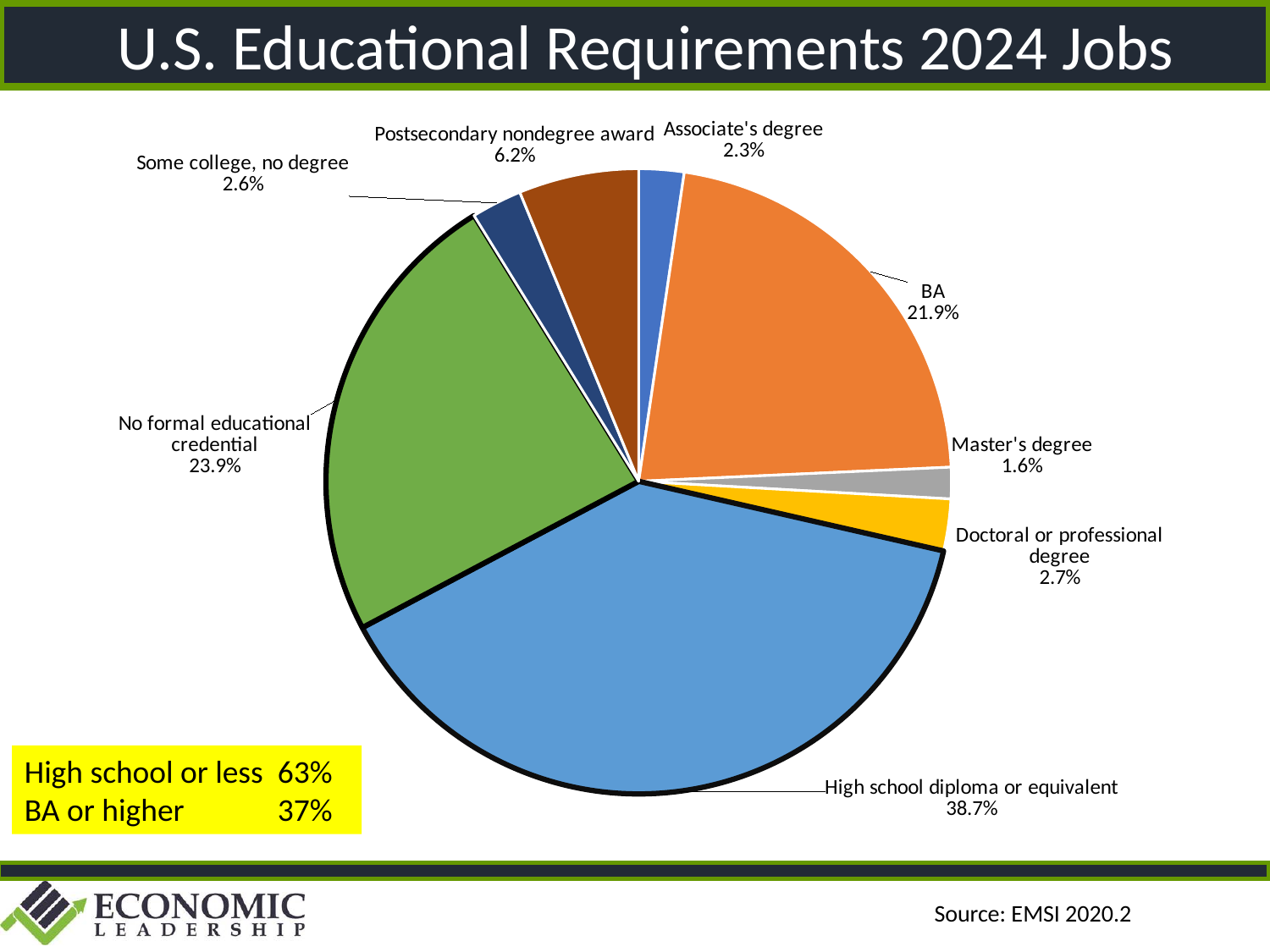
What is the title of the chart on the slide? U.S. Educational Requirements 2024 Jobs Which is larger: the share for Doctoral or professional degree or the share for Associate's degree? Doctoral or professional degree What is the difference in percentage points between the High school diploma or equivalent slice and the No formal educational credential slice? 14.8 What share of 2024 jobs requires a postsecondary nondegree award? 6.2% What share of 2024 jobs requires a Master's degree? 1.6% What share of 2024 jobs requires a BA? 21.9% What share of 2024 jobs requires a high school diploma or equivalent? 38.7% What kind of chart is shown on the slide? Pie chart What is the combined share of the BA and Master's degree slices? 23.5% Which educational requirement has the smallest share of 2024 jobs? Master's degree Which educational requirement has the largest share of 2024 jobs? High school diploma or equivalent How many slices does the pie chart have? 8